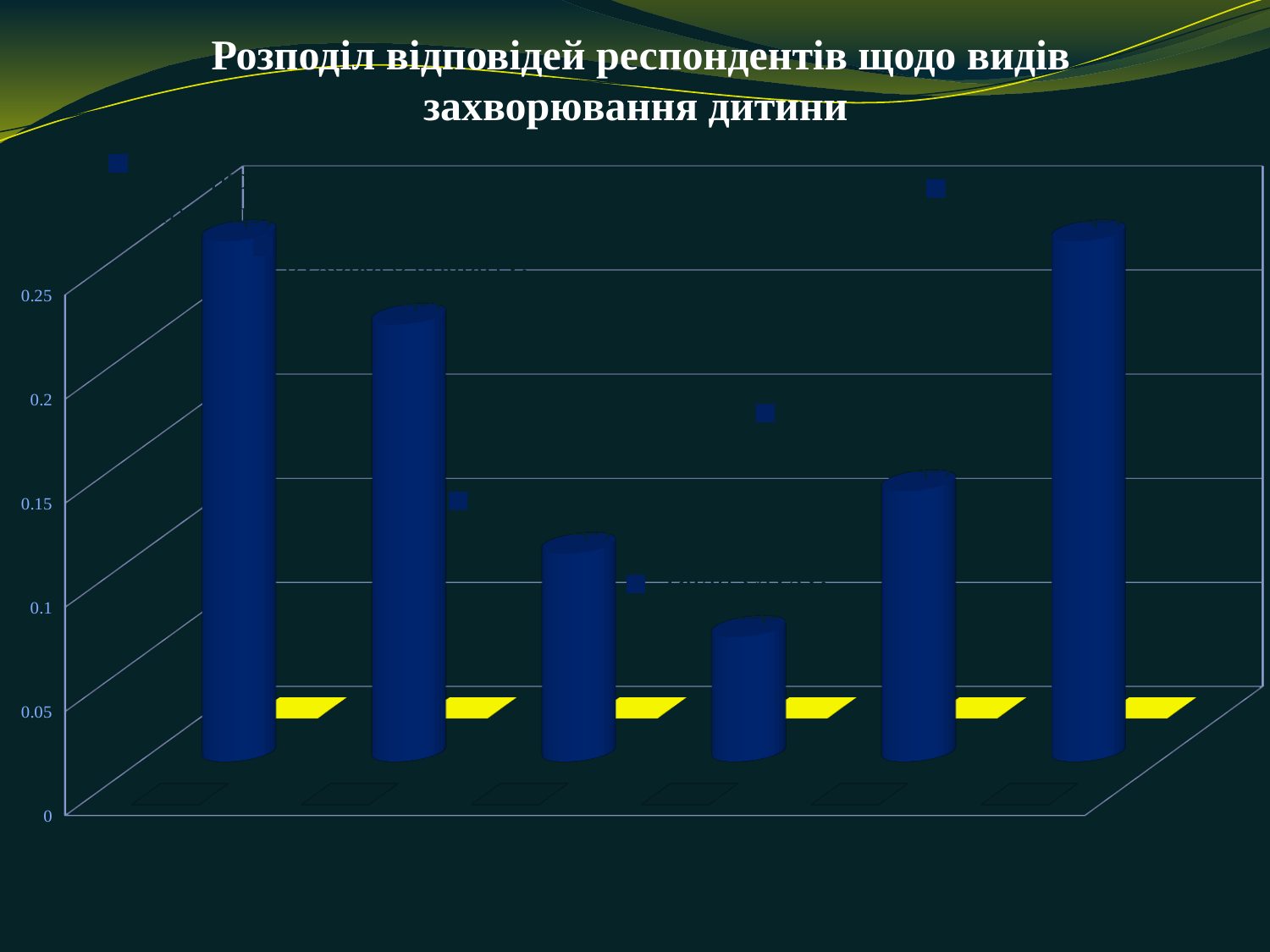
Which is larger, the fourth bar from the left or the fifth bar from the left? the fifth bar What is the highest value shown on the vertical axis? 0.25 What is the title of the chart? Розподіл відповідей респондентів щодо видів захворювання дитини What kind of chart is shown on the slide? bar chart Is the value of the second bar from the left greater or less than 0.2? greater Which bar is the lowest in the chart, counting from the left? the fourth bar How many bars are plotted in the chart? 6 Which is larger, the second bar from the left or the third bar from the left? the second bar Is the value of the fourth bar from the left greater or less than 0.1? less